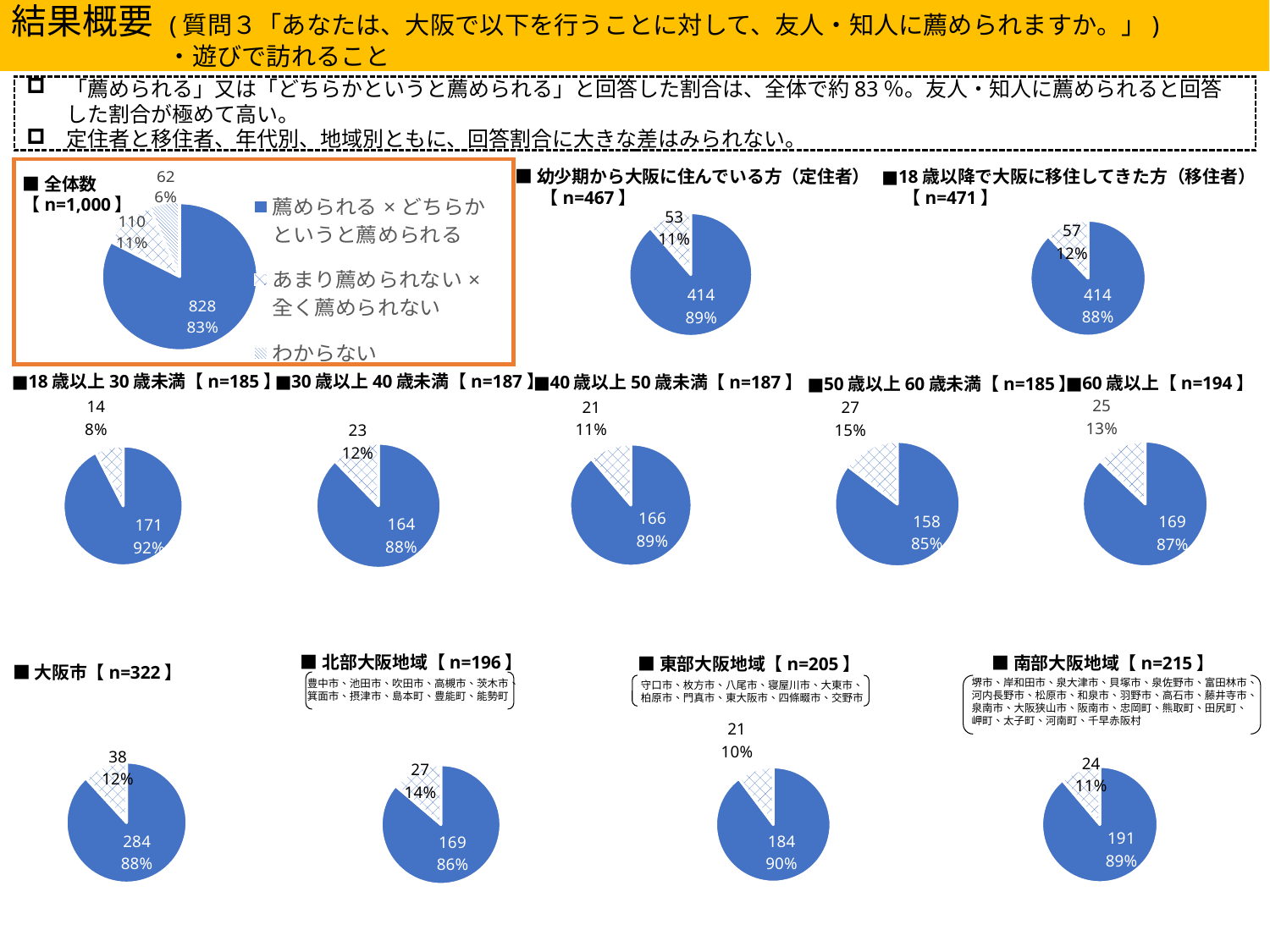
In the 50歳以上60歳未満【n=185】 pie chart, what is the count for the smaller slice? 27 In the 全体数【n=1,000】 pie chart, what is the count for 薦められる × どちらかというと薦められる? 828 How many entries does the legend of the 全体数【n=1,000】 pie chart list? 3 In the 大阪市【n=322】 pie chart, what is the difference between the two slice counts (284 and 38)? 246 In the 東部大阪地域【n=205】 pie chart, what percentage is shown for the smaller slice? 10% Which is larger: the large blue slice percentage in the 18歳以上30歳未満【n=185】 chart or in the 50歳以上60歳未満【n=185】 chart? 18歳以上30歳未満【n=185】 In the 全体数【n=1,000】 pie chart, what share of the pie is わからない? 6% How many pie charts are shown in the bottom row (地域別) of the slide? 4 In the 18歳以上30歳未満【n=185】 pie chart, what percentage is shown for the large blue slice? 92% In the 南部大阪地域【n=215】 pie chart, what is the count for the large blue slice? 191 What kind of chart is used for the 幼少期から大阪に住んでいる方（定住者）【n=467】 data? Pie chart In the 18歳以降で大阪に移住してきた方（移住者）【n=471】 pie chart, what percentage is shown for the smaller slice? 12%